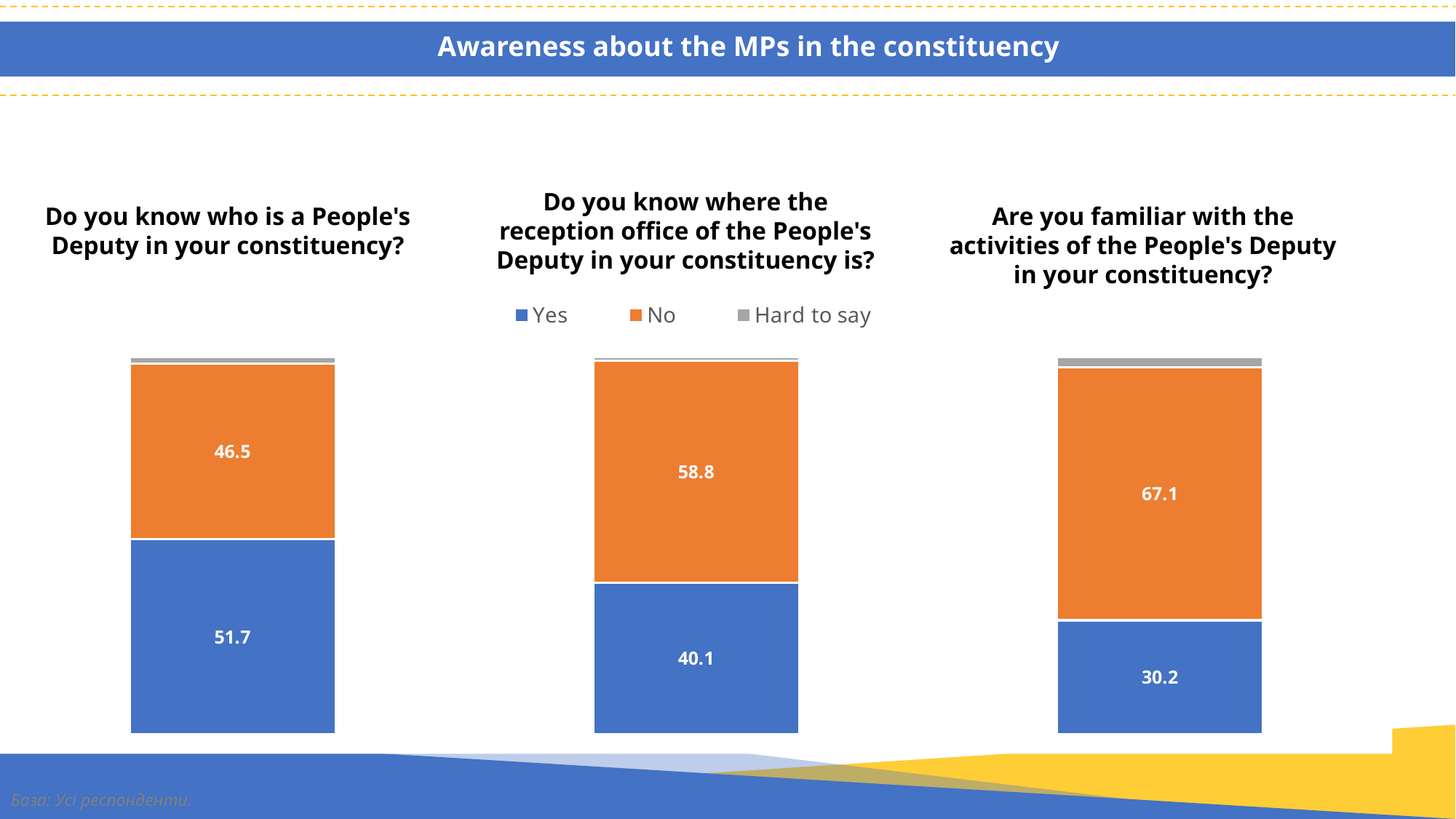
Across the three charts, which question has the lowest value for Yes? Are you familiar with the activities of the People's Deputy in your constituency? Across the three charts, which question has the highest value for No? Are you familiar with the activities of the People's Deputy in your constituency? In the right-hand chart, about familiarity with the Deputy's activities, what is the difference between the No and Yes values? 36.9 In the chart titled "Do you know who is a People's Deputy in your constituency?", what is the value for No? 46.5 In the left-hand chart, about knowing who the People's Deputy is, which is larger: Yes or No? Yes In the chart titled "Do you know who is a People's Deputy in your constituency?", what is the value for Yes? 51.7 In the right-hand chart, "Are you familiar with the activities of the People's Deputy in your constituency?", what is the value for Yes? 30.2 In the right-hand chart, "Are you familiar with the activities of the People's Deputy in your constituency?", what is the value for No? 67.1 In the middle chart, about the reception office of the People's Deputy, what is the value for Yes? 40.1 How many series does the legend list for these charts? 3 In the middle chart, about the reception office of the People's Deputy, what is the value for No? 58.8 What kind of chart is used for the middle chart about the reception office? Stacked bar chart